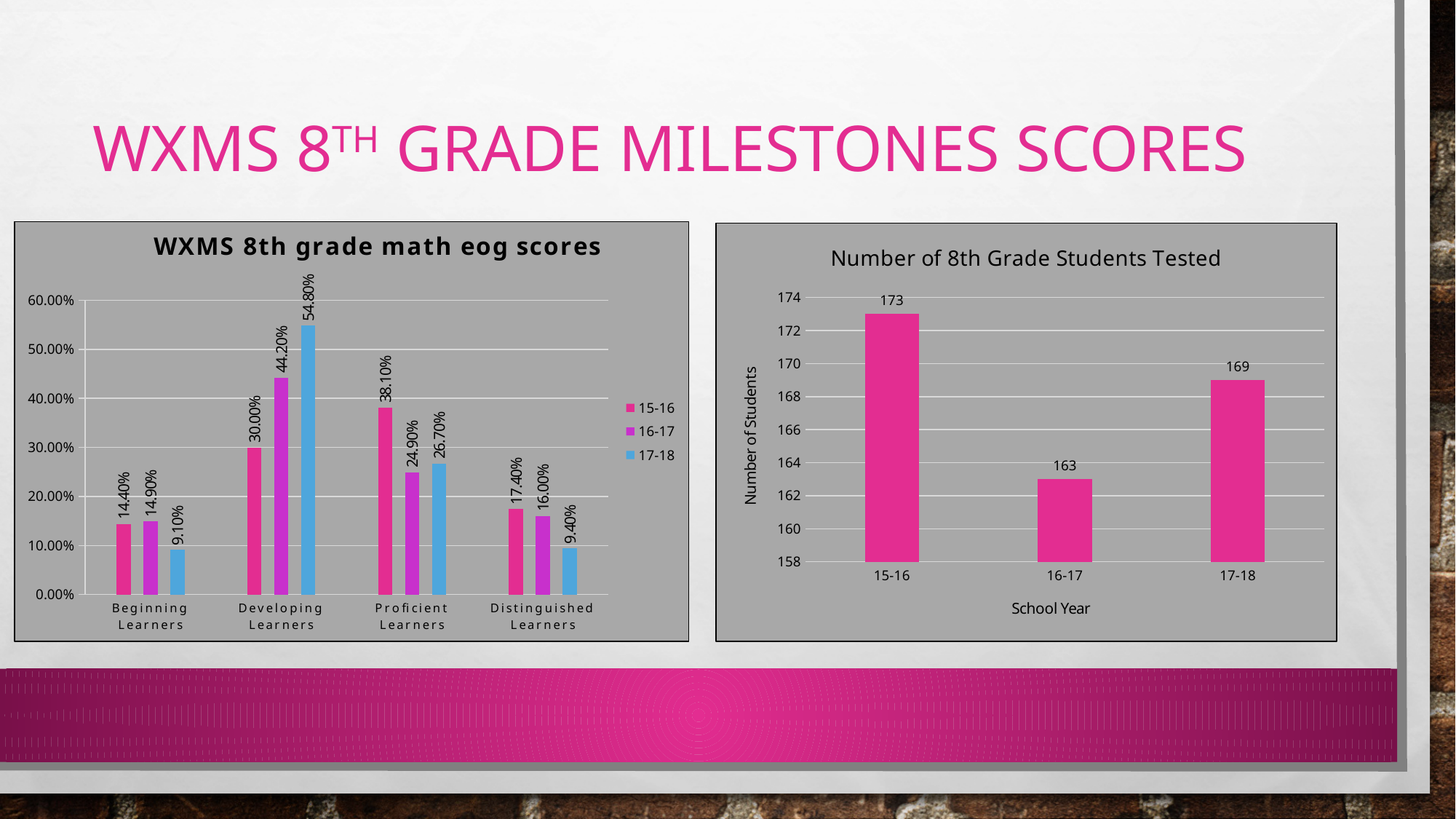
In the 'WXMS 8th grade math eog scores' chart, which category has the highest value for the 16-17 series? Developing Learners In the 'Number of 8th Grade Students Tested' chart, what is the difference between the number of students tested in 15-16 and 17-18? 4 How many series does the legend of the 'WXMS 8th grade math eog scores' chart list? 3 In the 'WXMS 8th grade math eog scores' chart, what is the difference between the 17-18 and 15-16 values for Developing Learners? 24.80% In the 'WXMS 8th grade math eog scores' chart, what is the value for Developing Learners in 17-18? 54.80% How many categories are shown on the x axis of the 'WXMS 8th grade math eog scores' chart? 4 In the 'Number of 8th Grade Students Tested' chart, how many students were tested in 16-17? 163 In the 'WXMS 8th grade math eog scores' chart, which category has the lowest value for the 17-18 series? Beginning Learners In the 'WXMS 8th grade math eog scores' chart, what is the value for Proficient Learners in 15-16? 38.10% In the 'Number of 8th Grade Students Tested' chart, which school year had the most students tested? 15-16 In the 'WXMS 8th grade math eog scores' chart, which is larger for Distinguished Learners: 15-16 or 16-17? 15-16 In the 'WXMS 8th grade math eog scores' chart, what is the value for Beginning Learners in 17-18? 9.10%